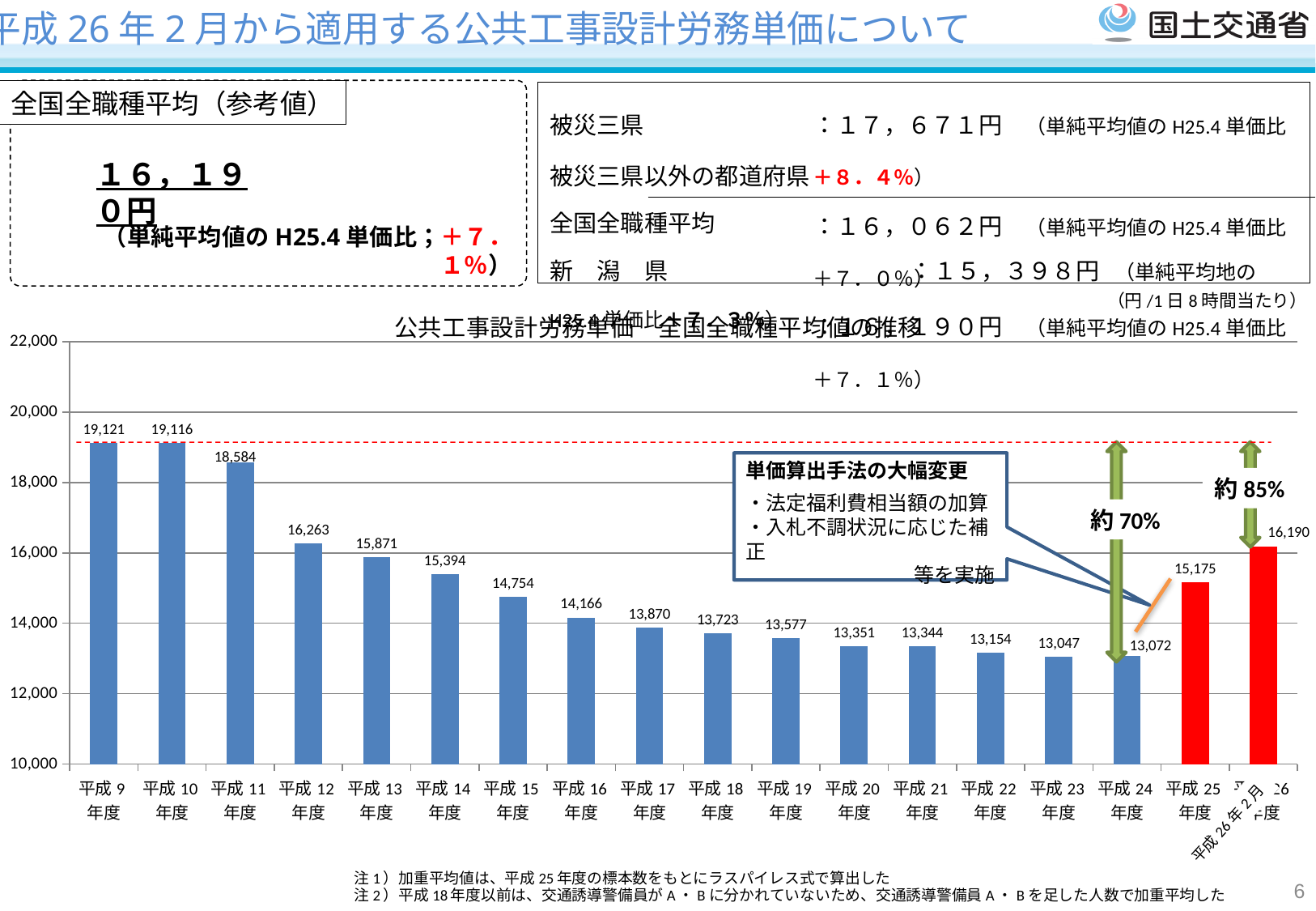
What is the value for 平成26年2月? 16,190 What is the value for 平成9年度? 19,121 Which is larger, the value for 平成12年度 or the value for 平成26年2月? 平成12年度 How many bars are plotted in the chart? 18 What is the difference between the values for 平成26年2月 and 平成25年度? 1,015 Which category has the lowest value? 平成23年度 What colour are the bars for 平成25年度 and 平成26年2月? red Which category has the highest value? 平成9年度 What is the value for 平成24年度? 13,072 What is the value for 平成25年度? 15,175 What type of chart is shown on the slide? bar chart Do the values generally rise or fall from 平成9年度 to 平成23年度? fall